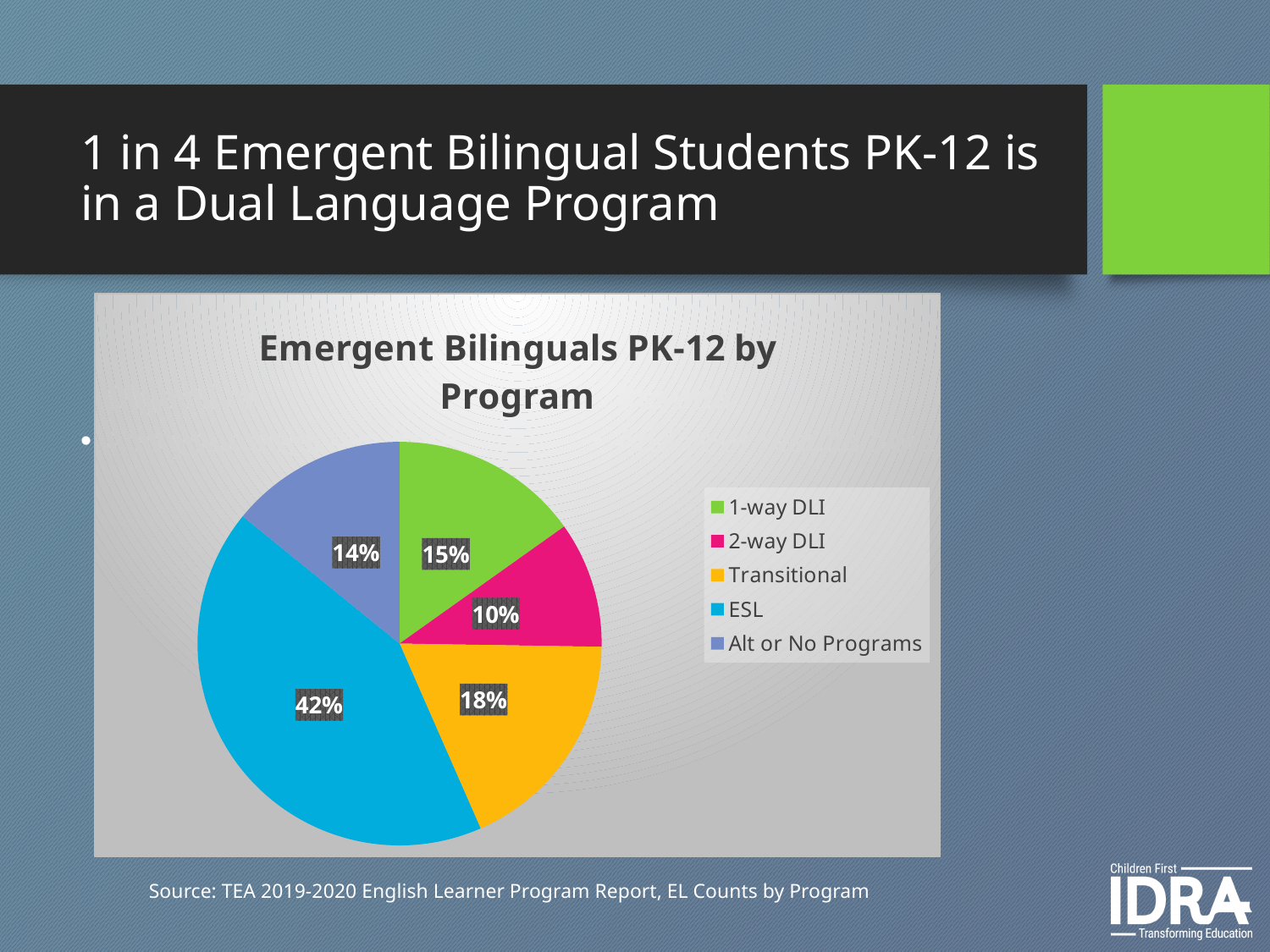
Which program has the largest share of emergent bilinguals PK-12? ESL What percentage of emergent bilinguals PK-12 are in Transitional programs? 18% What percentage of emergent bilinguals PK-12 are in ESL programs? 42% What type of chart is shown on the slide? pie chart Which program has the smallest share of emergent bilinguals PK-12? 2-way DLI What percentage of emergent bilinguals PK-12 are in 2-way DLI programs? 10% What is the difference in percentage points between the ESL share and the Transitional share? 24 What percentage of emergent bilinguals PK-12 are in 1-way DLI programs? 15% What is the title of the chart? Emergent Bilinguals PK-12 by Program How many program categories does the legend list? 5 What percentage of emergent bilinguals PK-12 are in Alt or No Programs? 14% Which has a larger share, 1-way DLI or Alt or No Programs? 1-way DLI